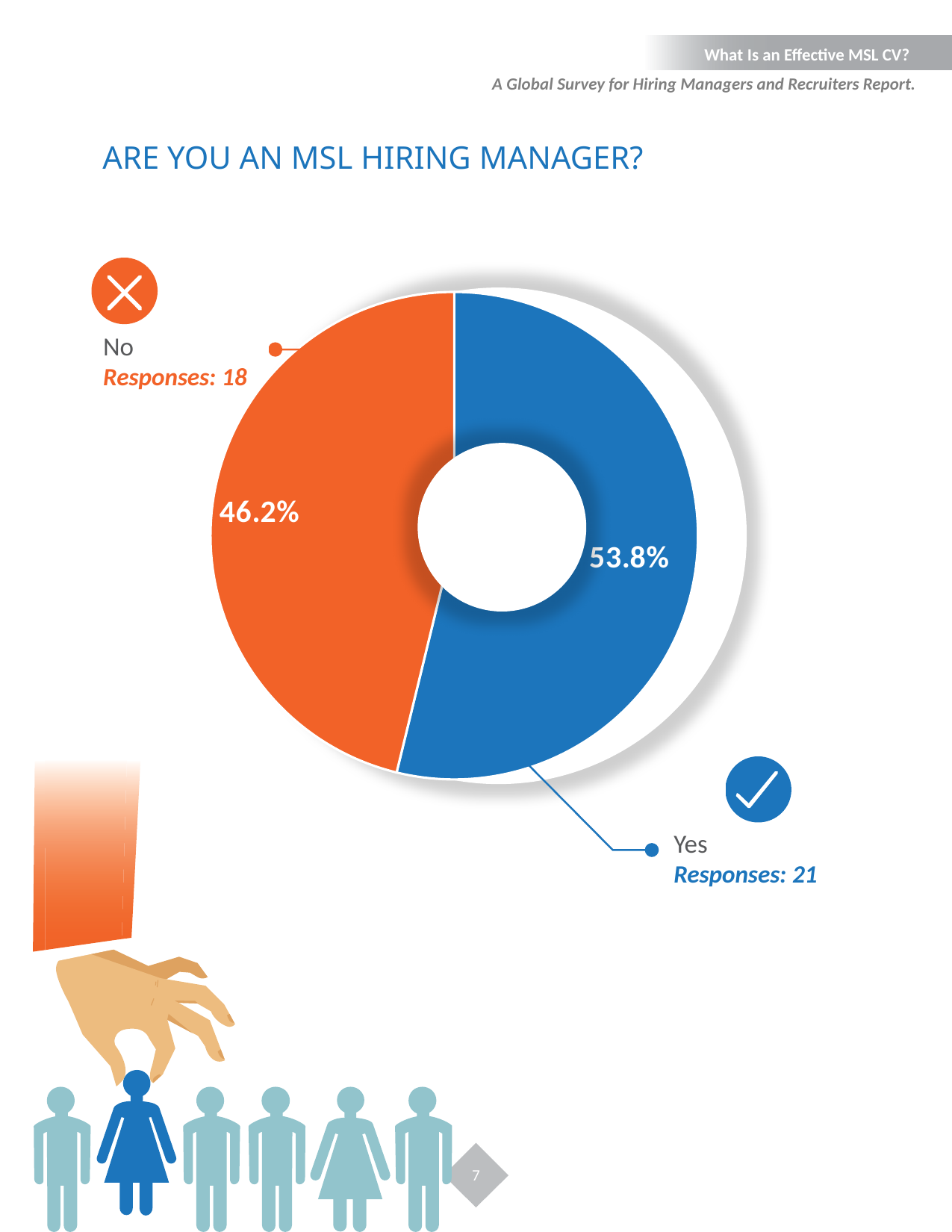
What is the difference in percentage points between the Yes and No slices? 7.6 What is the total number of responses shown on the chart? 39 Which answer received the larger share of responses, Yes or No? Yes How many responses were recorded for No? 18 What percentage of respondents answered No to being an MSL hiring manager? 46.2% How many more responses did Yes receive than No? 3 How many categories does the chart show? 2 What colour is the slice representing No? Orange Which category has the smallest slice of the chart? No How many responses were recorded for Yes? 21 What type of chart is shown on the slide? Pie chart What percentage of respondents answered Yes to being an MSL hiring manager? 53.8%